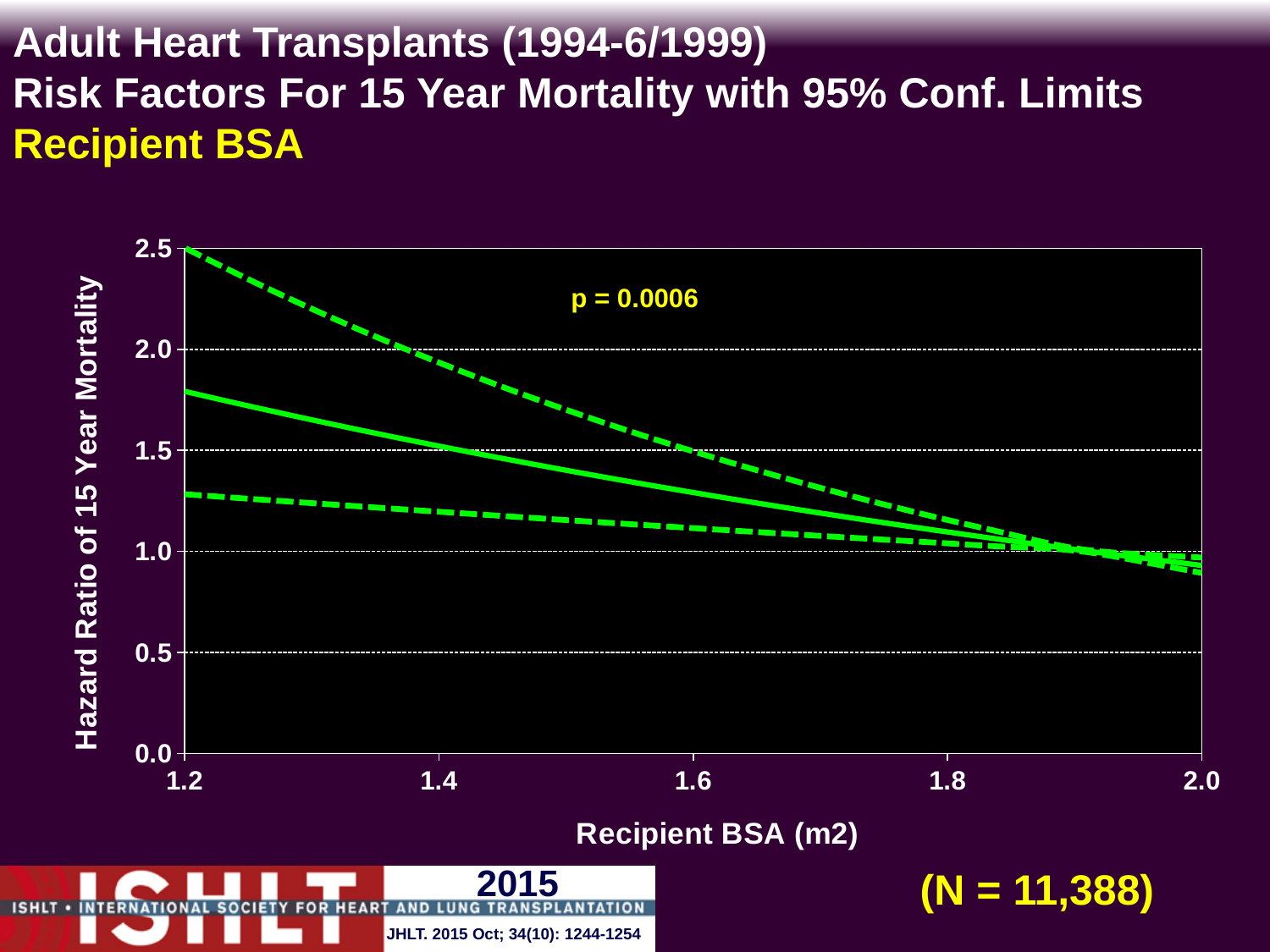
What is the sample size (N) shown on the slide? N = 11,388 Is the hazard ratio (solid line) at a Recipient BSA of 1.6 greater or less than 1.5? less Is the upper confidence limit (upper dashed line) at a Recipient BSA of 1.2 greater or less than 2.0? greater What is the highest value shown on the y axis? 2.5 How many lines are plotted on the chart? 3 What is the label of the x axis? Recipient BSA (m2) Is the lower confidence limit (lower dashed line) at a Recipient BSA of 1.2 greater or less than 1.5? less Does the hazard ratio (solid line) rise or fall as Recipient BSA increases from 1.2 to 2.0? fall What kind of chart is shown on the slide? line chart